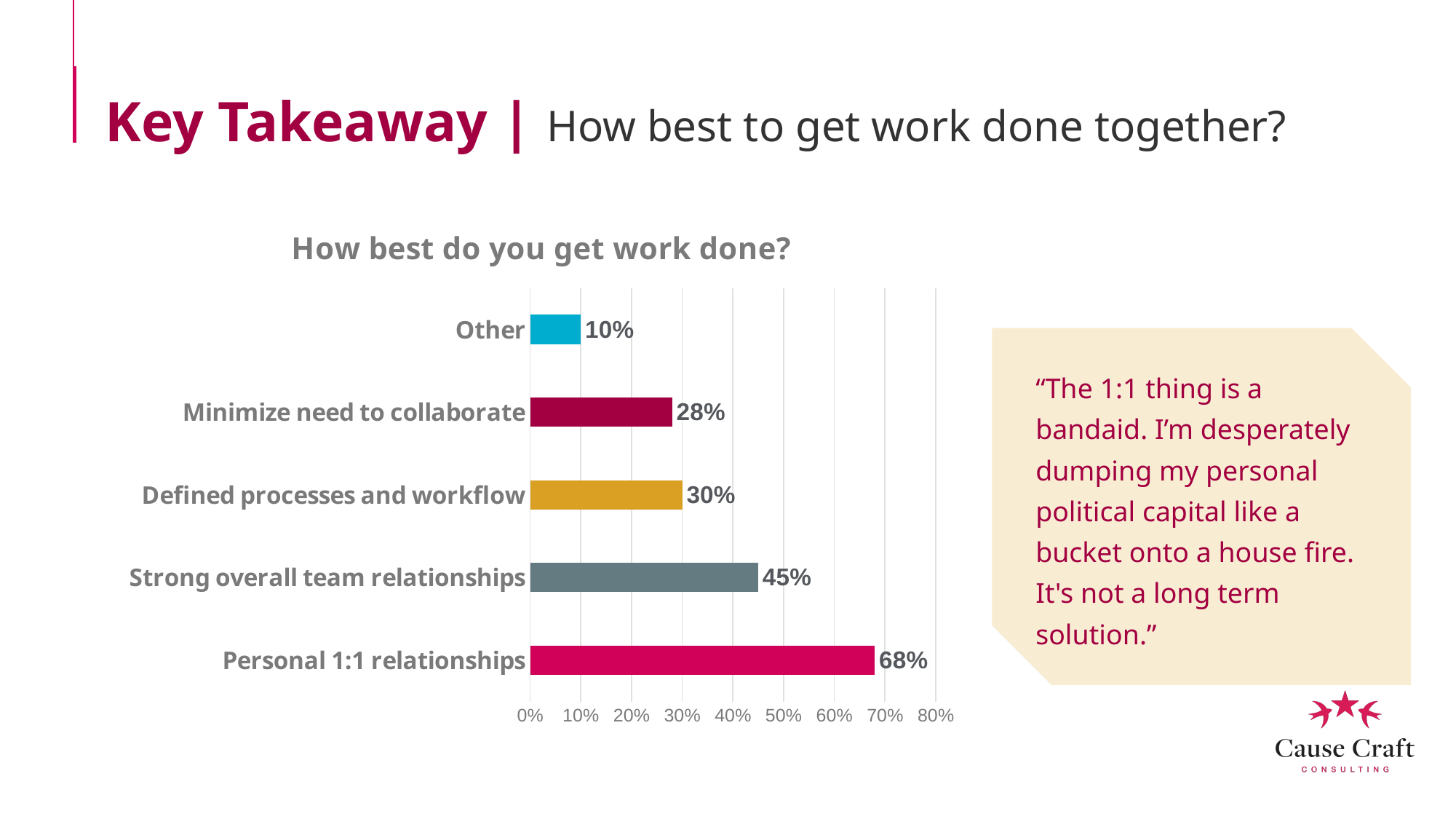
Which is larger, Defined processes and workflow or Minimize need to collaborate? Defined processes and workflow Which category has the lowest value? Other What kind of chart is shown on the slide? Bar chart How many categories are shown in the chart? 5 What is the title of the chart? How best do you get work done? What is the difference between Personal 1:1 relationships and Strong overall team relationships? 23% What is the value for Personal 1:1 relationships? 68% What is the value for Defined processes and workflow? 30% What is the value for Other? 10% What is the value for Strong overall team relationships? 45% What is the value for Minimize need to collaborate? 28% Which category has the highest value? Personal 1:1 relationships